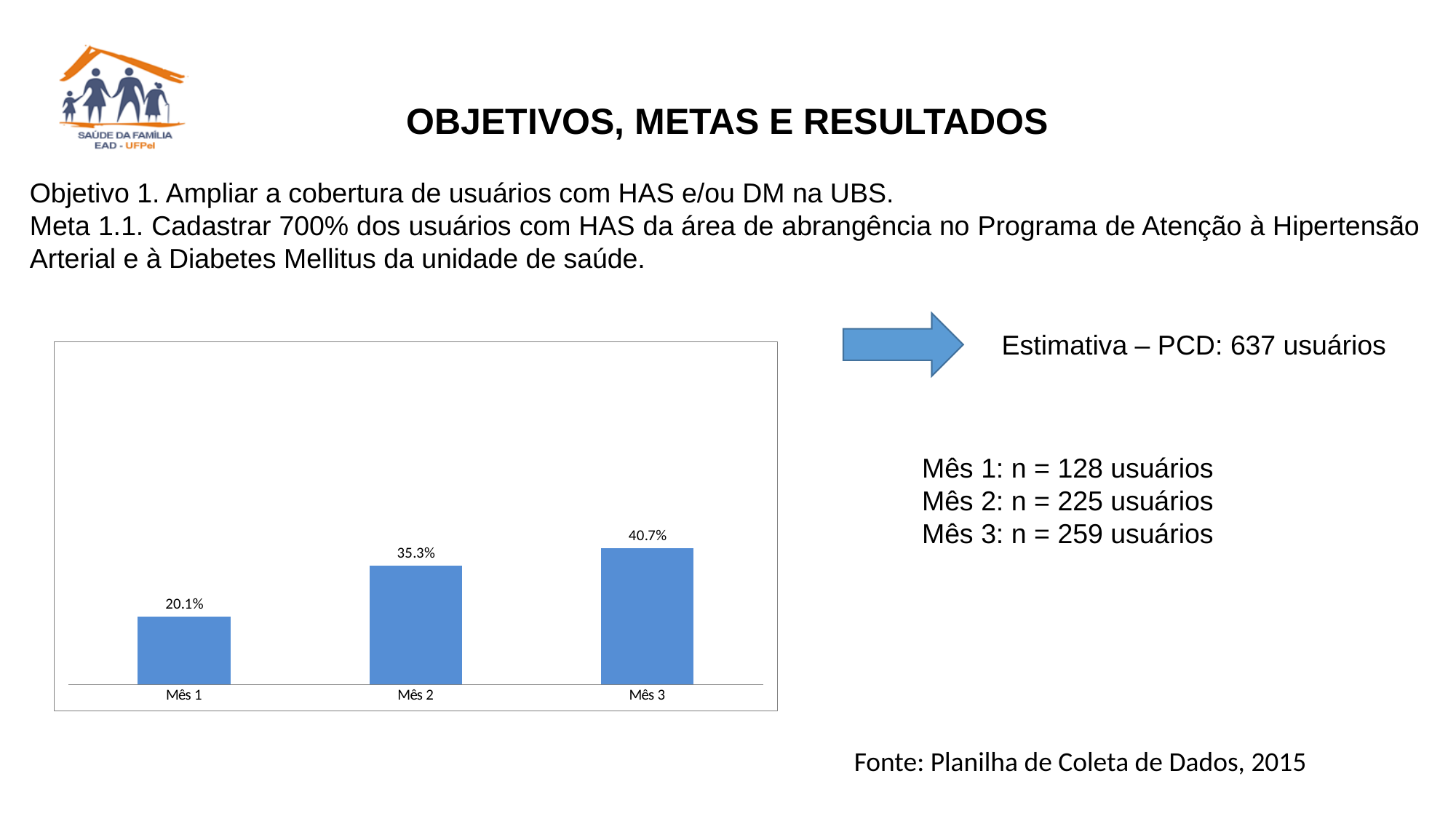
What kind of chart is shown on the slide? Bar chart What is the difference between the values for Mês 2 and Mês 1? 15.2% Which month has the lowest value? Mês 1 Do the values rise or fall from Mês 1 to Mês 3? Rise What is the value for Mês 2? 35.3% What colour are the bars in the chart? Blue What is the value for Mês 1? 20.1% Which is larger, the value for Mês 2 or Mês 3? Mês 3 What is the difference between the values for Mês 3 and Mês 1? 20.6% How many bars are shown in the chart? 3 Which month has the highest value? Mês 3 What is the value for Mês 3? 40.7%